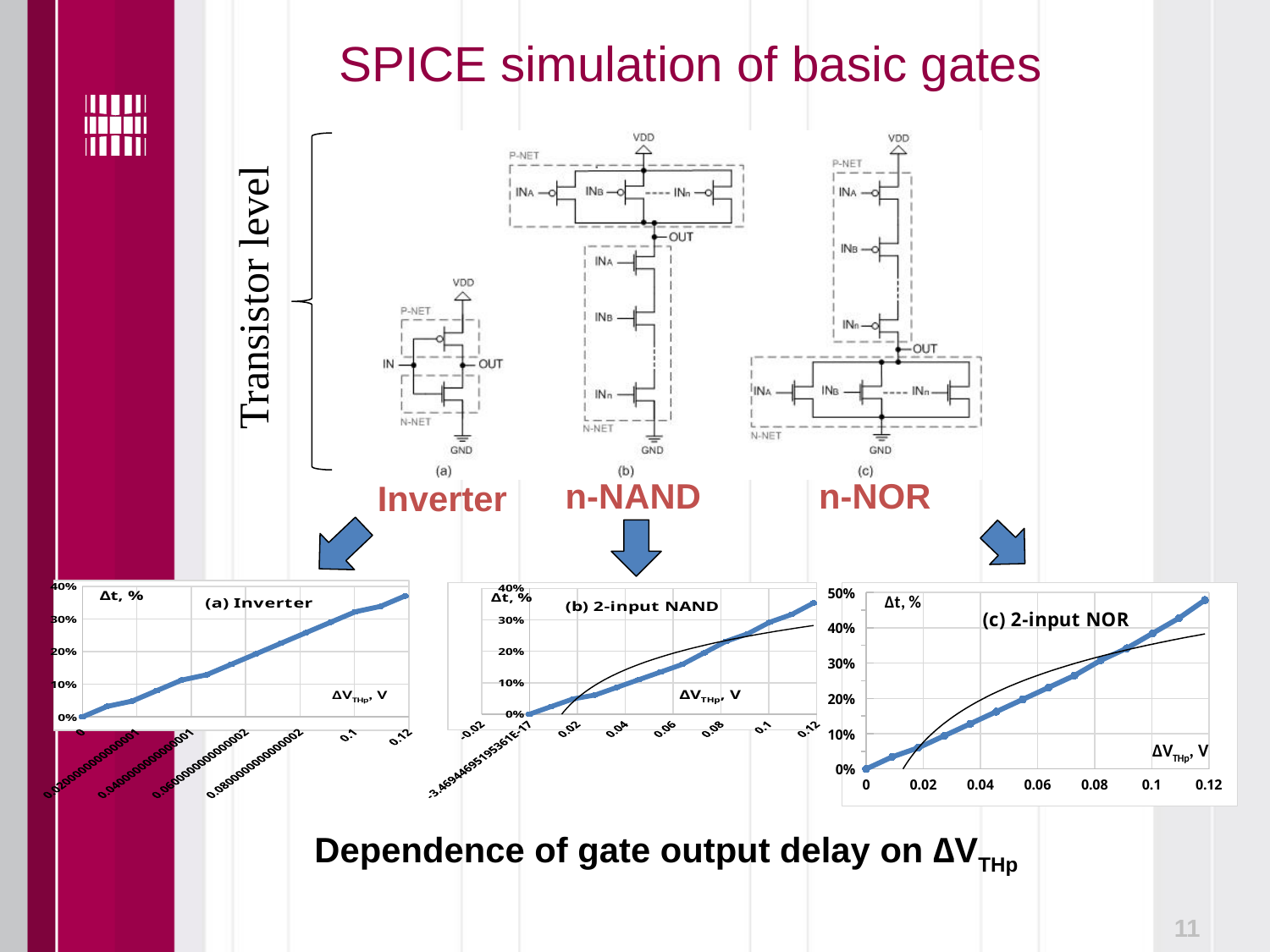
What is the highest y-axis tick shown on the (c) 2-input NOR chart? 50% In the (b) 2-input NAND chart, is the value at ΔVTHp = 0.12 V greater or less than 30%? greater In the (c) 2-input NOR chart, is the value at ΔVTHp = 0.12 V greater or less than 40%? greater What is the label of the y axis in the (c) 2-input NOR chart? Δt, % In the (c) 2-input NOR chart, is the value at ΔVTHp = 0.04 V greater or less than 20%? less In the (a) Inverter chart, do the values rise or fall along the x axis? rise How many charts are shown at the bottom of the slide? 3 What kind of chart is the (a) Inverter chart? line chart In the (c) 2-input NOR chart, do the plotted values rise or fall as ΔVTHp increases along the x axis? rise